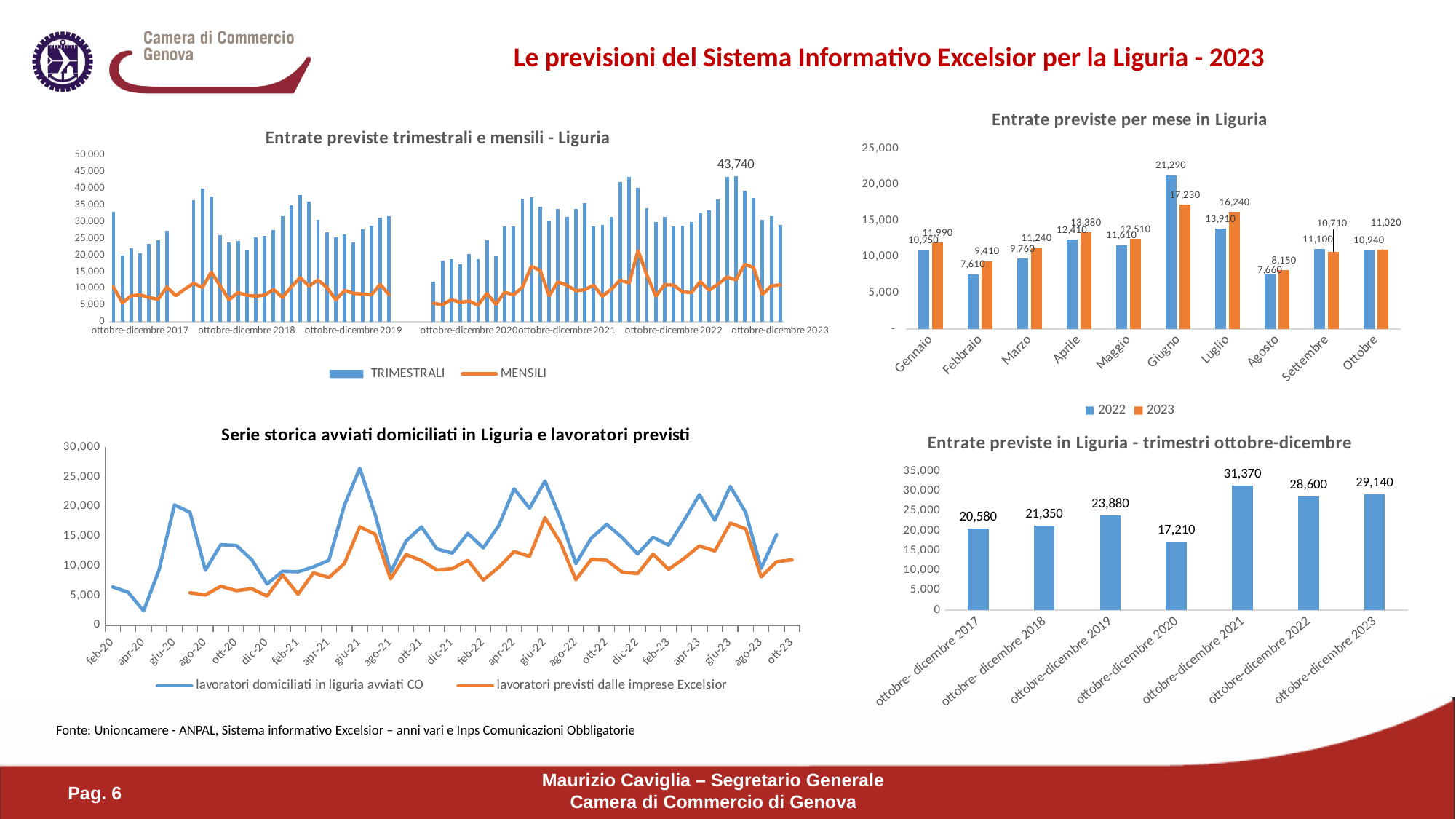
How many series does the legend of the chart 'Entrate previste per mese in Liguria' list? 2 In the chart 'Entrate previste in Liguria - trimestri ottobre-dicembre', what is the difference between ottobre-dicembre 2023 and ottobre-dicembre 2022? 540 What kind of chart is 'Serie storica avviati domiciliati in Liguria e lavoratori previsti'? Line chart In the chart 'Entrate previste in Liguria - trimestri ottobre-dicembre', what is the value for ottobre-dicembre 2020? 17,210 In the chart 'Entrate previste per mese in Liguria', which is larger for Settembre: the 2022 value or the 2023 value? 2022 In the chart 'Entrate previste per mese in Liguria', what is the value for Giugno in 2022? 21,290 How many bars are shown in the chart 'Entrate previste in Liguria - trimestri ottobre-dicembre'? 7 In the chart 'Entrate previste trimestrali e mensili - Liguria', what is the only data label printed on the bars? 43,740 In the chart 'Entrate previste per mese in Liguria', what is the value for Luglio in 2023? 16,240 In the chart 'Entrate previste per mese in Liguria', which month has the lowest 2022 value? Febbraio In the chart 'Entrate previste in Liguria - trimestri ottobre-dicembre', which quarter has the highest value? ottobre-dicembre 2021 In the chart 'Entrate previste per mese in Liguria', what is the difference between the 2022 and 2023 values for Giugno? 4,060